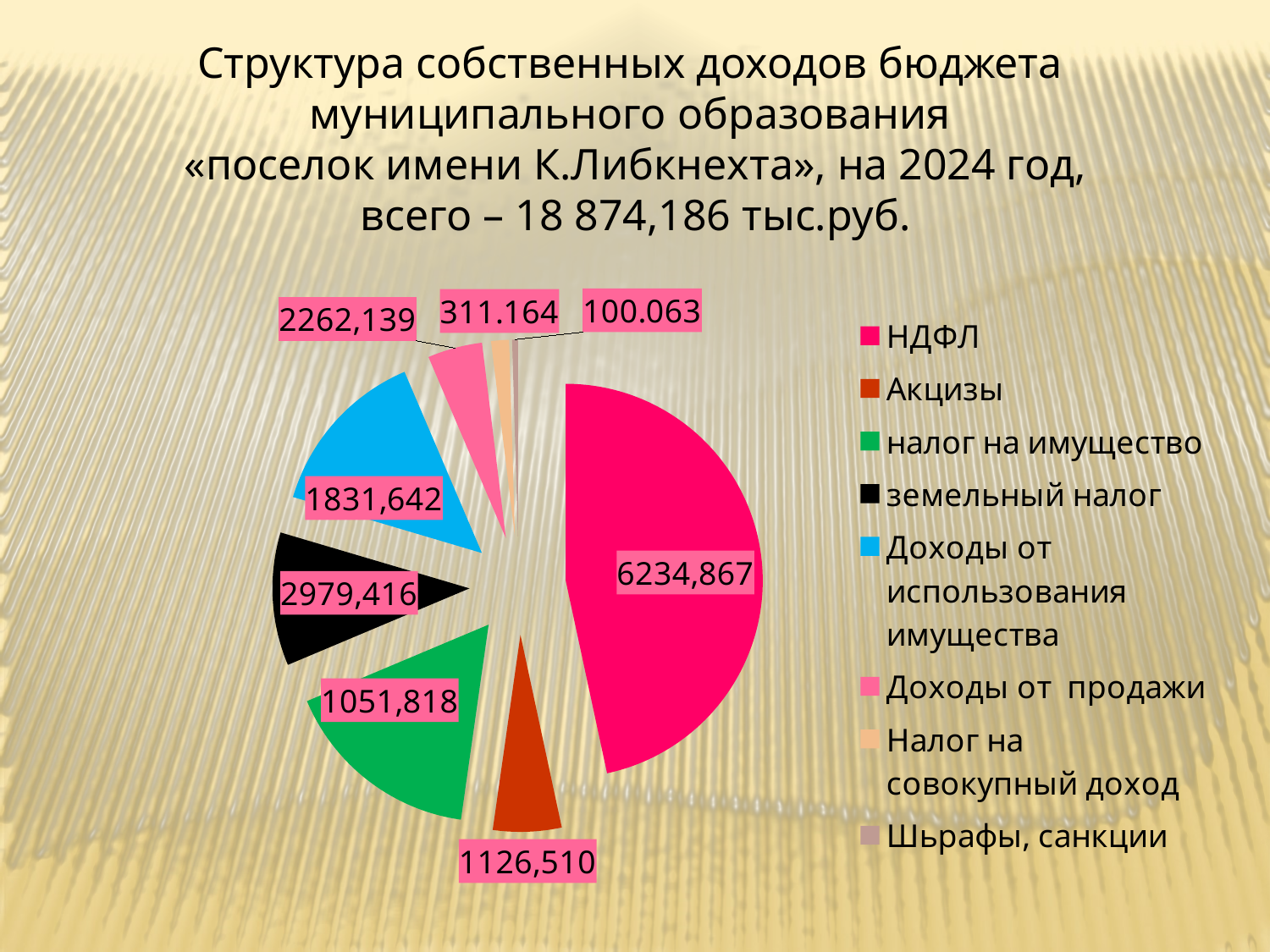
What is the value shown for НДФЛ? 6234,867 Which category has the smallest slice of the pie? Шьрафы, санкции What is the value shown for земельный налог? 2979,416 Which category has the largest slice of the pie? НДФЛ What is the value shown for Шьрафы, санкции? 100.063 What is the value shown for Акцизы? 1126,510 What is the difference between the values for НДФЛ and Акцизы? 5108,357 How many categories does the legend list? 8 Which is larger, the value for земельный налог or the value for налог на имущество? земельный налог What type of chart is shown on the slide? Pie chart What colour is the slice for Акцизы? Dark red (brown) What is the value shown for Доходы от использования имущества? 1831,642